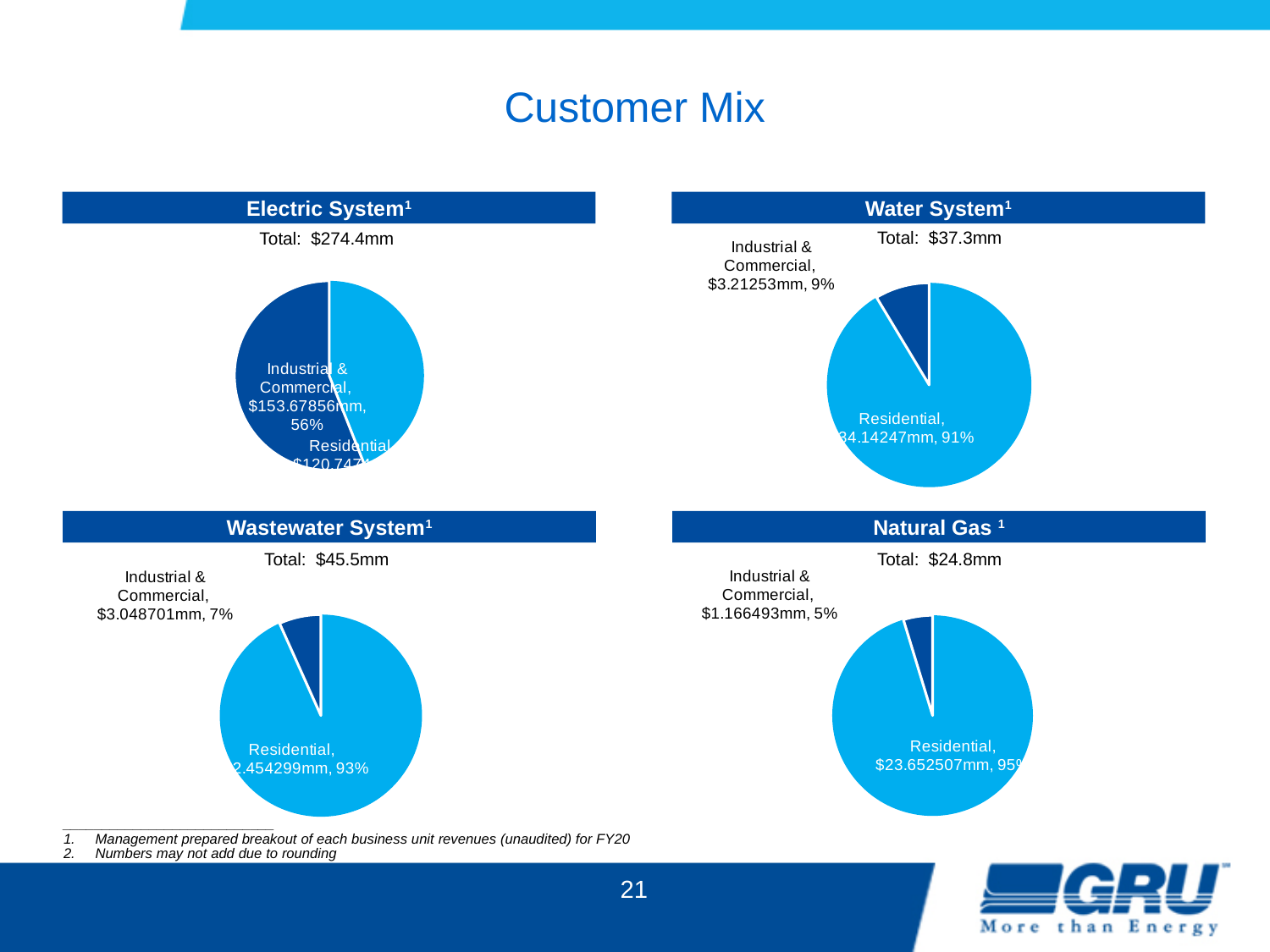
In the Water System chart, what is the value for Industrial & Commercial? $3.21253mm In the Wastewater System chart, what share of the pie is Residential? 93% In the Electric System chart, what share of the pie is Industrial & Commercial? 56% In the Natural Gas chart, what is the value for Residential? $23.652507mm In the Water System chart, which slice is the largest? Residential In the Water System chart, what share of the pie is Residential? 91% In the Electric System chart, which slice is larger, Industrial & Commercial or Residential? Industrial & Commercial In the Wastewater System chart, what is the value for Industrial & Commercial? $3.048701mm What kind of chart is used for the Electric System? pie chart How many pie charts are shown on the slide? 4 In the Electric System chart, what is the value for Industrial & Commercial? $153.67856mm